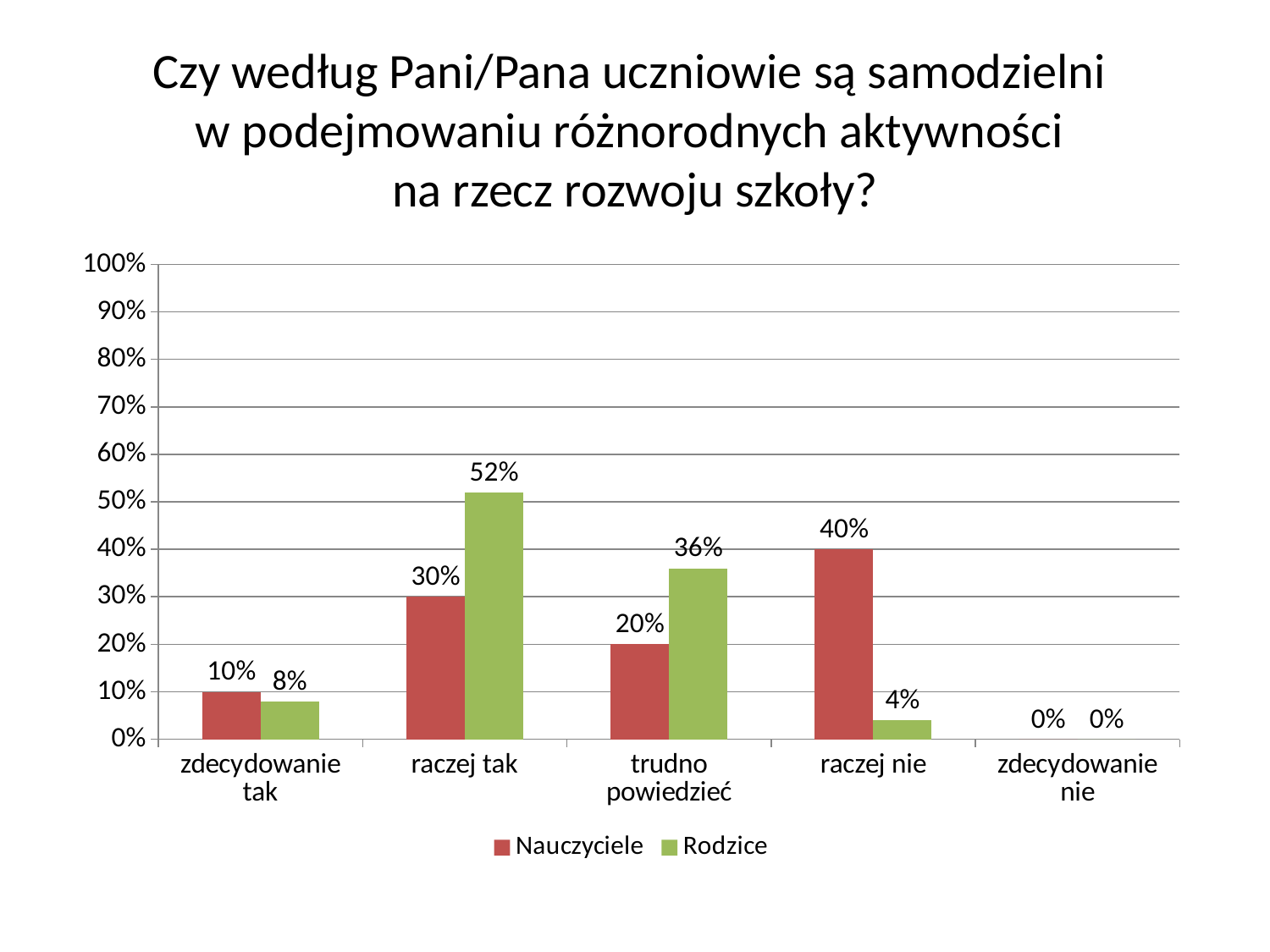
How many series does the legend list? 2 Which category has the highest value for Rodzice? raczej tak What is the value for Rodzice in the 'raczej tak' category? 52% What kind of chart is shown on the slide? bar chart What is the value for Nauczyciele in the 'trudno powiedzieć' category? 20% What is the difference between the Rodzice and Nauczyciele values in the 'raczej tak' category? 22% What is the value for Nauczyciele in the 'raczej nie' category? 40% What is the value for Rodzice in the 'zdecydowanie tak' category? 8% Which category has the highest value for Nauczyciele? raczej nie What is the difference between the Nauczyciele and Rodzice values in the 'raczej nie' category? 36% In the 'trudno powiedzieć' category, which series has the larger value, Nauczyciele or Rodzice? Rodzice How many categories are shown on the x axis? 5